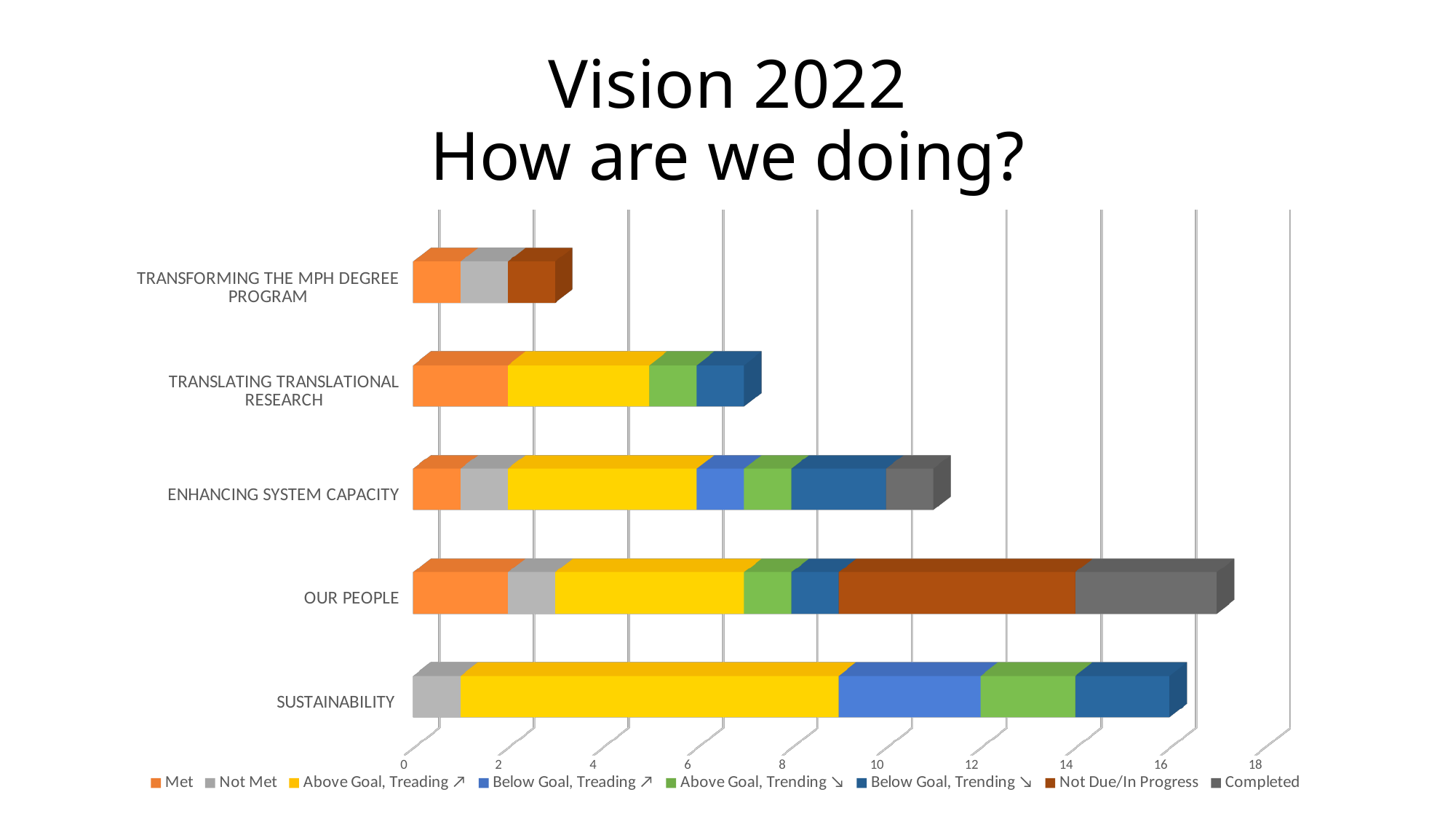
How many series does the chart's legend list? 8 What is the title shown above the chart? Vision 2022 How are we doing? What kind of chart is shown on the slide? Stacked bar chart Which legend entry is shown in yellow? Above Goal, Treading ↗ How many categories are plotted on the vertical axis of the chart? 5 Is the total bar length for Translating Translational Research greater or less than 8? less Which has the longer total bar, Enhancing System Capacity or Translating Translational Research? Enhancing System Capacity Which category has the shortest total bar? Transforming the MPH Degree Program Is the total bar length for Enhancing System Capacity greater or less than 10? greater Is the total bar length for Sustainability greater or less than 14? greater Which category has the longest total bar? Our People